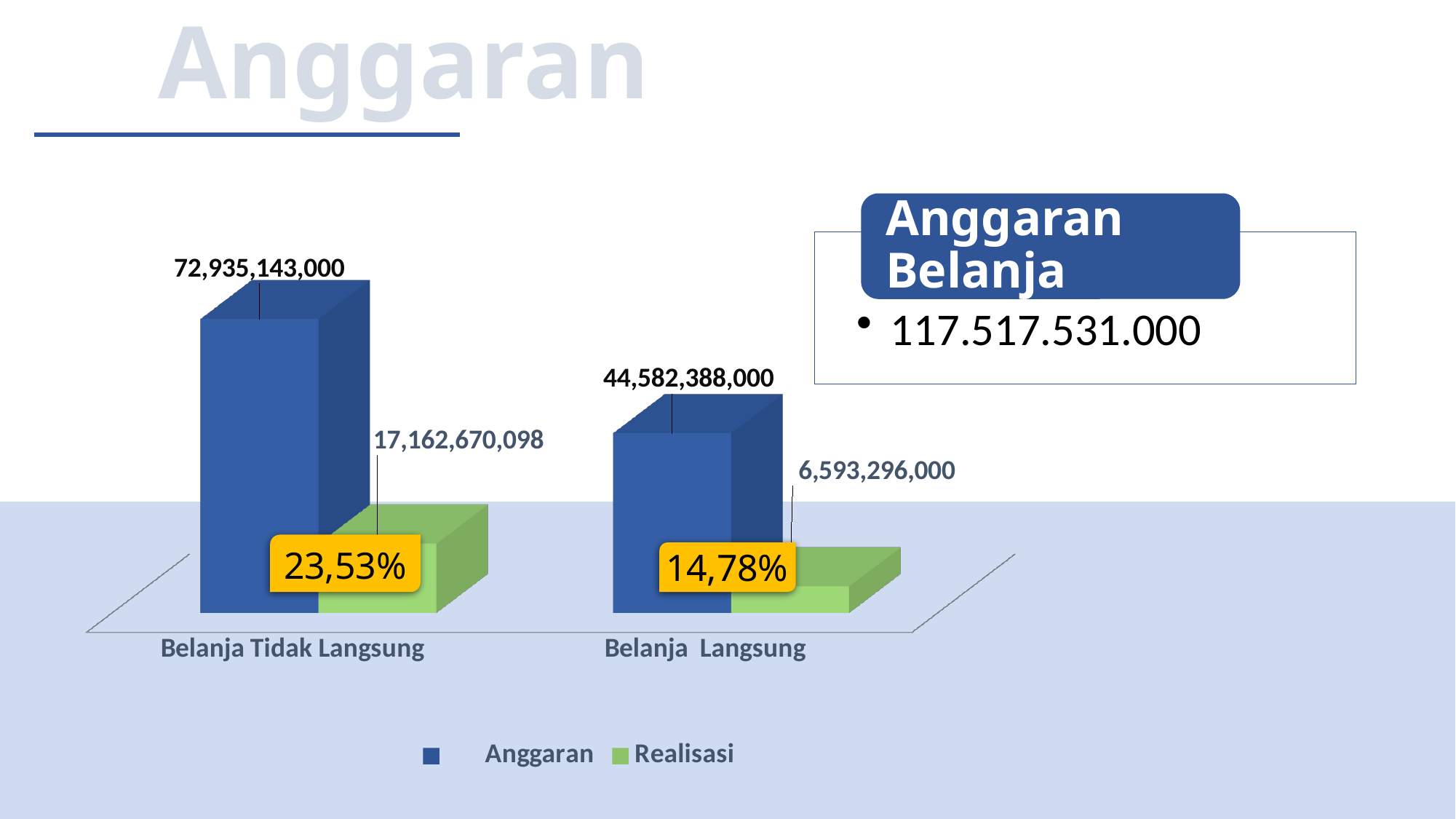
Which category has the lower Realisasi value? Belanja Langsung What is the Anggaran value for Belanja Tidak Langsung? 72,935,143,000 What is the Realisasi value for Belanja Tidak Langsung? 17,162,670,098 How many series does the legend list? 2 What type of chart is shown on the slide? bar chart What is the difference between the Anggaran and Realisasi values for Belanja Langsung? 37,989,092,000 Which colour represents the Realisasi series in the chart? green What is the Realisasi value for Belanja Langsung? 6,593,296,000 Which category has the higher Anggaran value? Belanja Tidak Langsung Is the Realisasi value for Belanja Tidak Langsung larger or smaller than the Anggaran value for Belanja Langsung? smaller What is the Anggaran value for Belanja Langsung? 44,582,388,000 What is the difference between the Anggaran values for Belanja Tidak Langsung and Belanja Langsung? 28,352,755,000